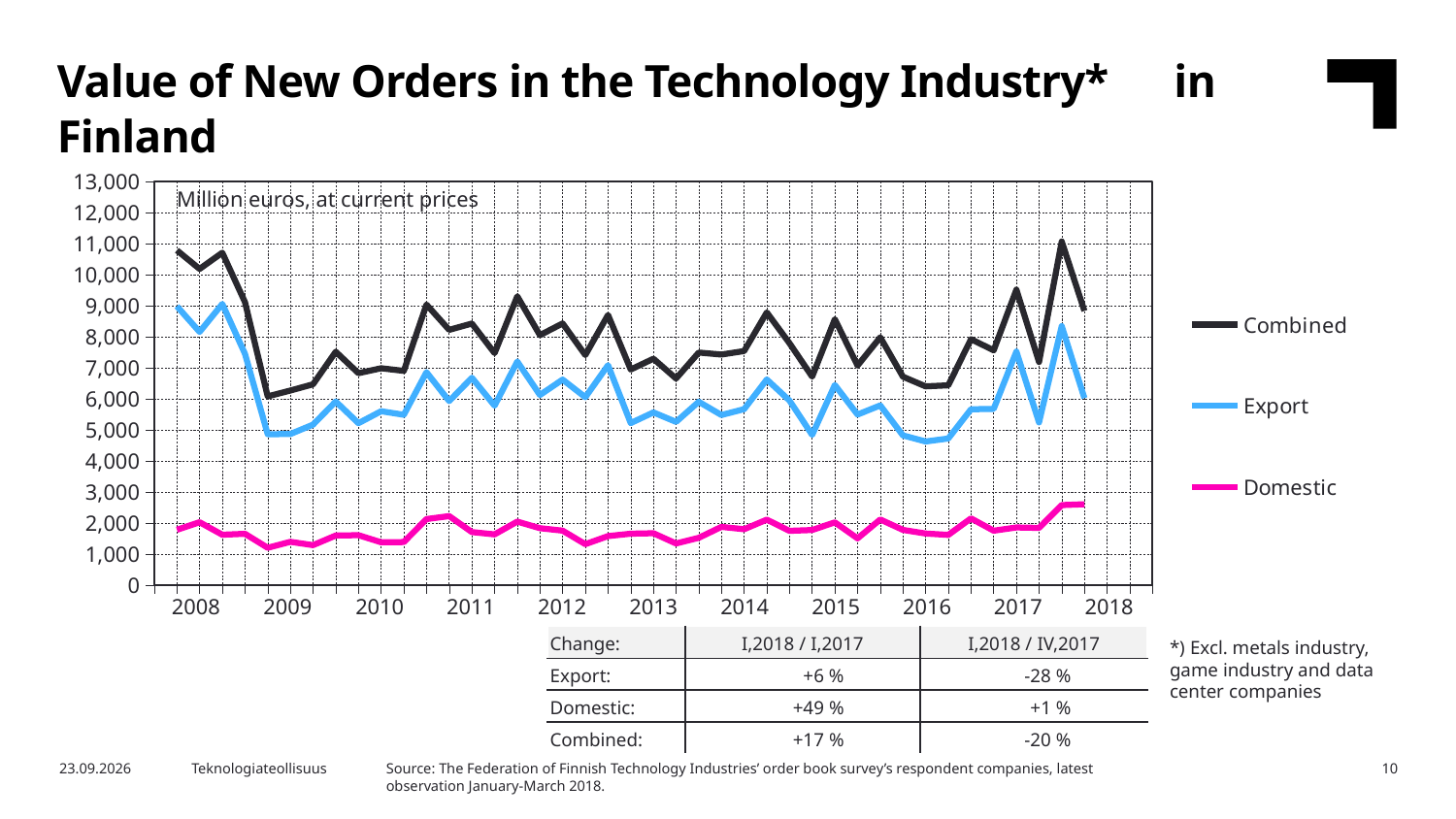
What unit note is printed inside the chart area? Million euros, at current prices How many year labels are shown on the x axis? 11 Does the Combined series rise or fall from the start of 2008 to the start of 2009? Fall Is the value for Domestic at the start of 2008 greater or less than 3,000? less How many series does the chart legend list? 3 Which series has the highest values throughout the chart? Combined Is the value for Export at the start of 2016 greater or less than 5,000? less Is the value for Combined at the start of 2008 greater or less than 10,000? greater Which series has the lowest values throughout the chart? Domestic Which is larger at the start of 2018, the Combined value or the Export value? Combined What kind of chart is shown on the slide? Line chart